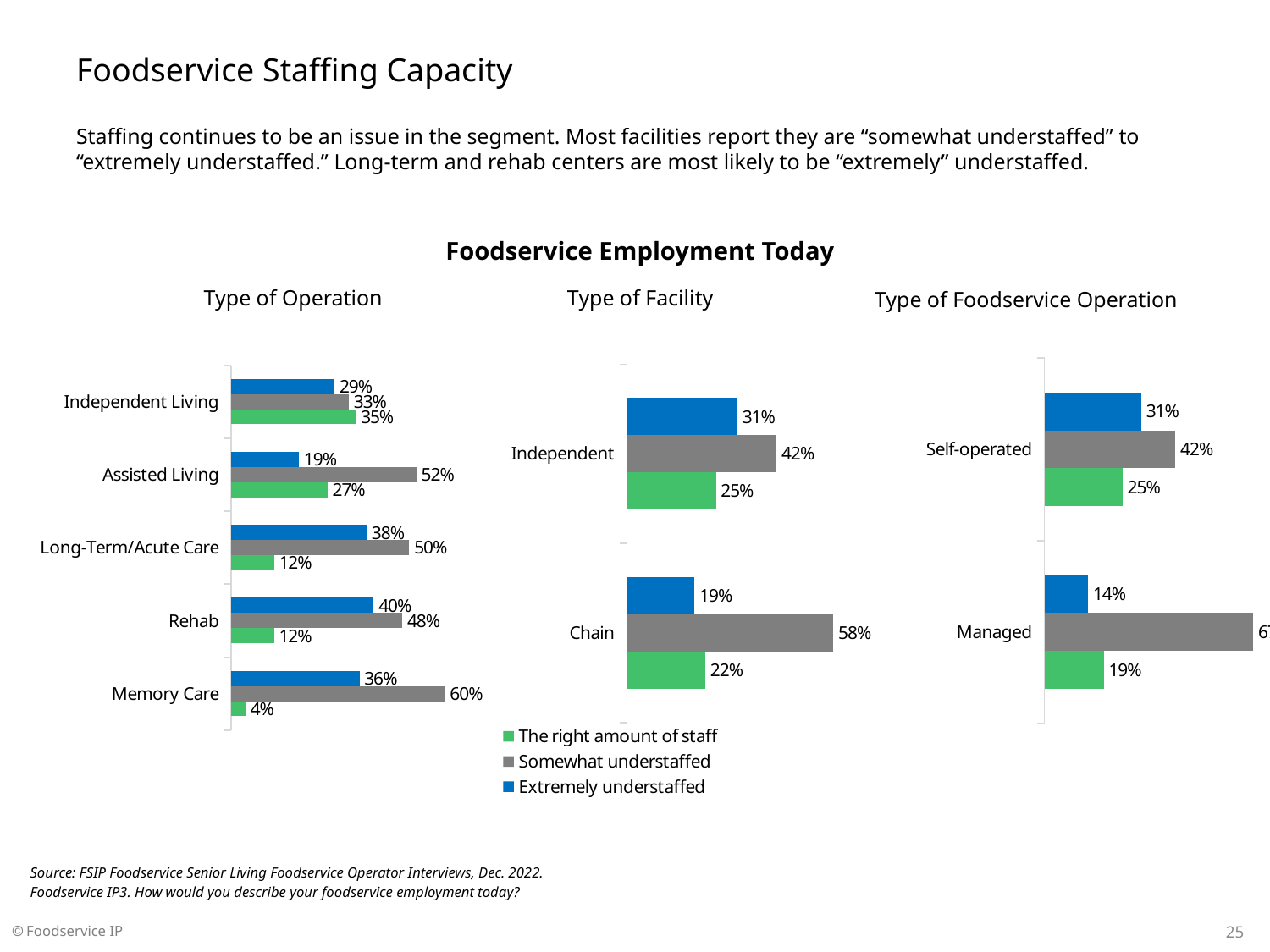
In the Type of Operation chart, what percentage of Rehab facilities report being extremely understaffed? 40% What kind of chart is the Type of Facility chart? Bar chart In the Type of Foodservice Operation chart, what is the difference between the 'Extremely understaffed' values for Self-operated and Managed? 17% In the Type of Facility chart, what percentage of Chain facilities report being somewhat understaffed? 58% In the Type of Facility chart, which is larger: the 'Extremely understaffed' value for Independent or for Chain? Independent In the Type of Operation chart, which type of operation has the highest value for 'Extremely understaffed'? Rehab In the Type of Foodservice Operation chart, what percentage of Self-operated facilities report having the right amount of staff? 25% In the Type of Operation chart, what percentage of Memory Care facilities report being somewhat understaffed? 60% How many series does the legend list for the charts on this slide? 3 In the Type of Operation chart, how many types of operation are shown? 5 In the Type of Operation chart, which type of operation has the lowest value for 'The right amount of staff'? Memory Care In the Type of Operation chart, what is the difference between the 'Somewhat understaffed' values for Assisted Living and Independent Living? 19%